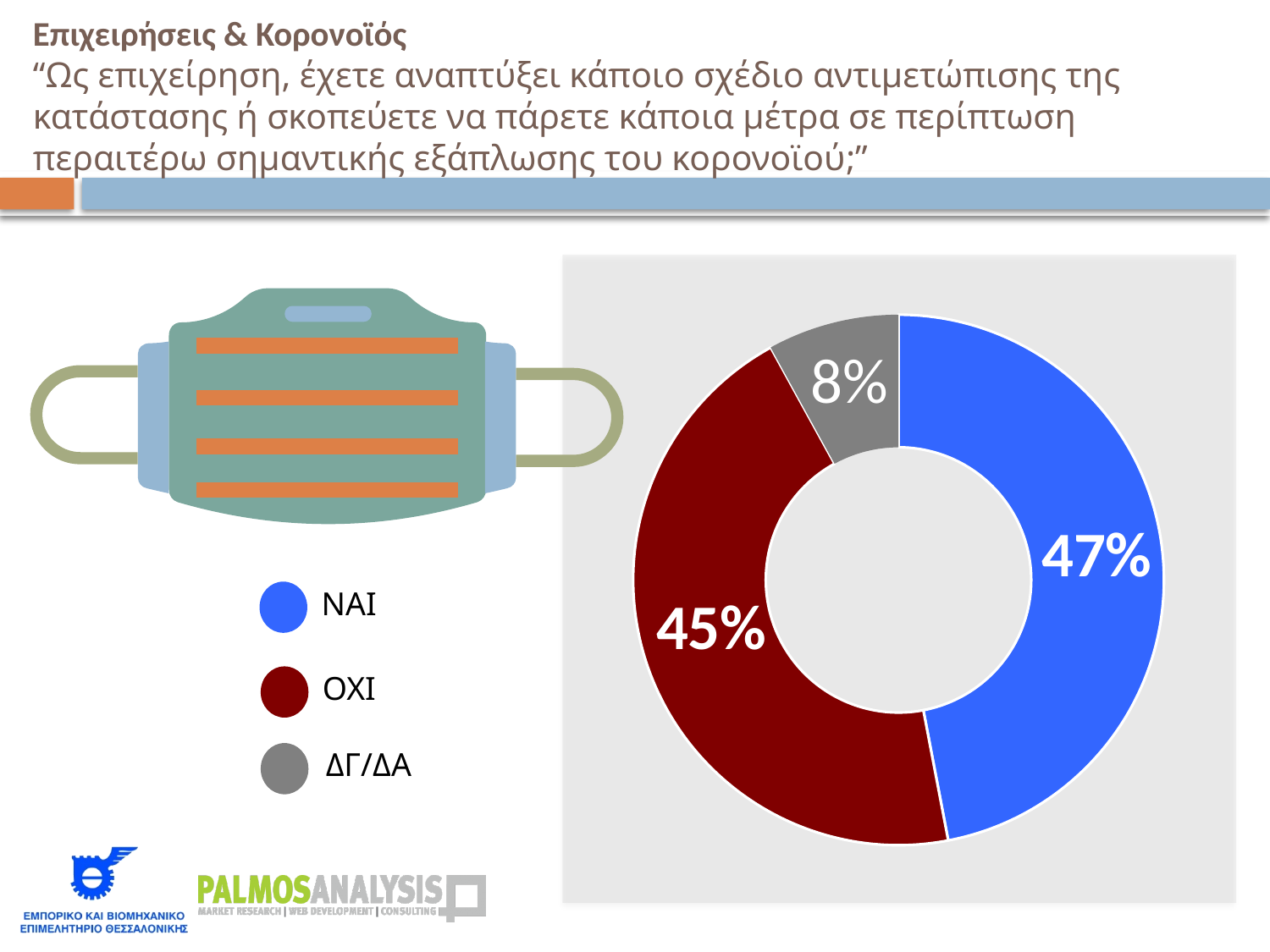
What percentage of businesses answered ΔΓ/ΔΑ? 8% Which is larger, the share for ΟΧΙ or the share for ΔΓ/ΔΑ? ΟΧΙ What percentage of businesses answered ΝΑΙ? 47% What is the difference in percentage points between ΝΑΙ and ΟΧΙ? 2 What colour represents ΟΧΙ in the chart? Dark red What kind of chart is shown on the slide? Doughnut (pie) chart What colour represents ΝΑΙ in the chart? Blue How many categories does the chart show? 3 What is the difference in percentage points between ΟΧΙ and ΔΓ/ΔΑ? 37 Which response has the largest share of the chart? ΝΑΙ What percentage of businesses answered ΟΧΙ? 45% Which response has the smallest share of the chart? ΔΓ/ΔΑ